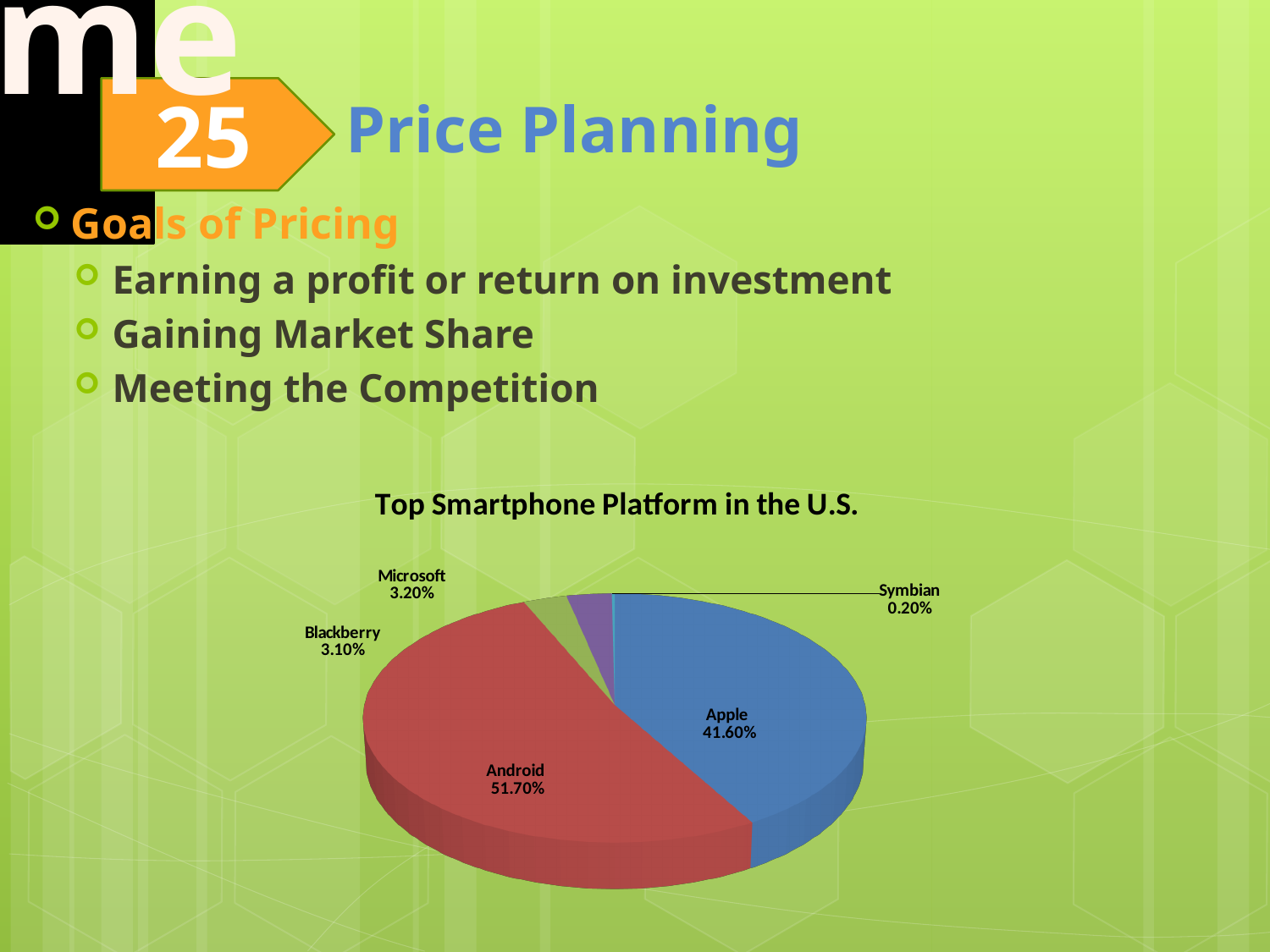
What is the value for Android in the pie chart? 51.70% How many platforms are shown in the pie chart? 5 Which has a larger share, Apple or Android? Android What kind of chart is shown on the slide? Pie chart Which platform has the smallest share in the pie chart? Symbian What is the value for Blackberry in the pie chart? 3.10% What is the value for Microsoft in the pie chart? 3.20% Which platform has the largest share in the pie chart? Android What is the title of the chart? Top Smartphone Platform in the U.S. What is the difference between the Android and Apple shares? 10.10% What is the value for Symbian in the pie chart? 0.20% What is the value for Apple in the pie chart? 41.60%